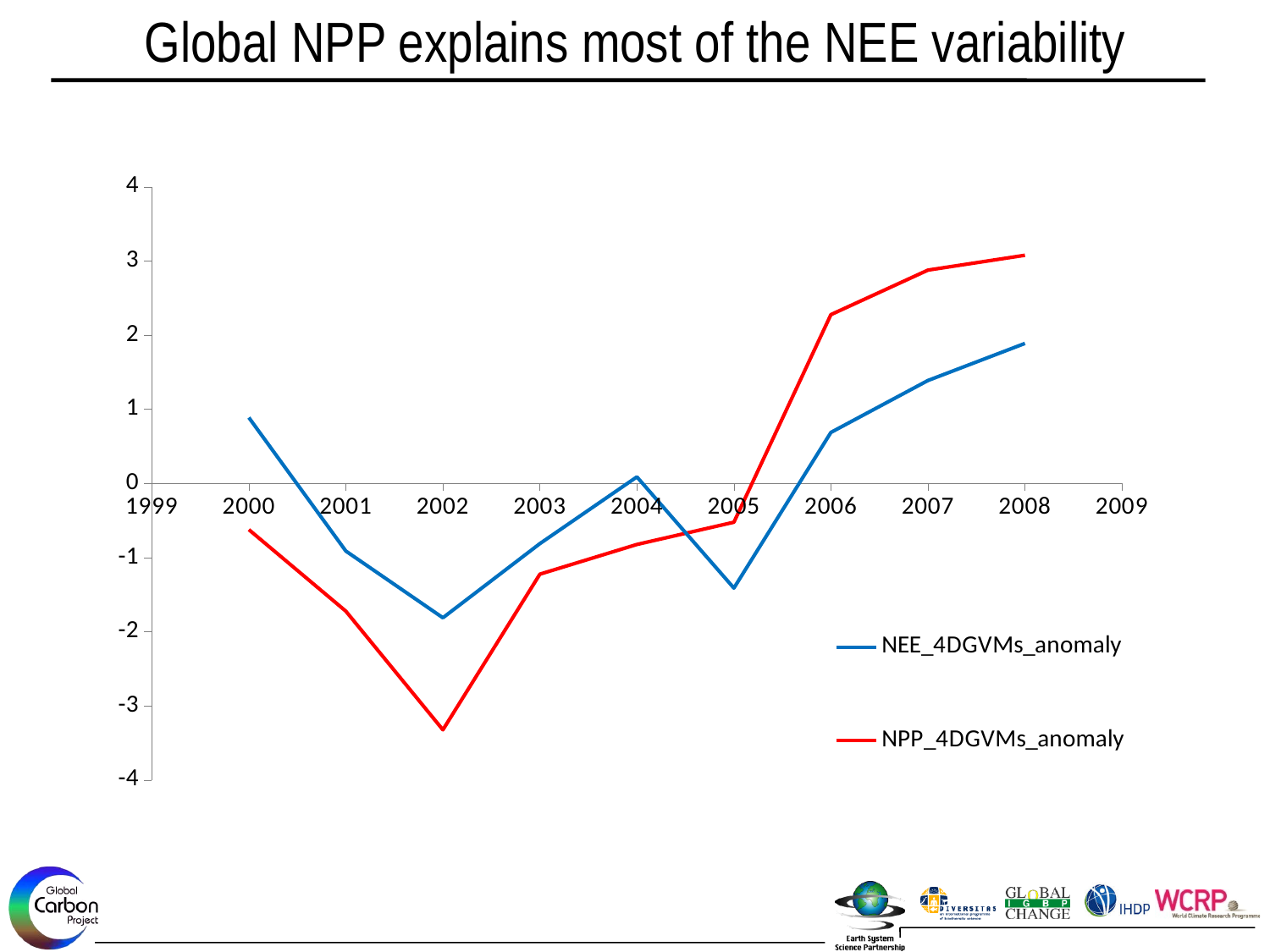
How many yearly data points does the NPP_4DGVMs_anomaly line have? 9 Is the NPP_4DGVMs_anomaly value for 2002 greater or less than -3? less In which year does the NEE_4DGVMs_anomaly line reach its lowest value? 2002 Is the NEE_4DGVMs_anomaly value for 2002 greater or less than -1? less What kind of chart is shown on the slide? line chart In which year does the NPP_4DGVMs_anomaly line reach its lowest value? 2002 In 2006, which series has the larger value, NEE_4DGVMs_anomaly or NPP_4DGVMs_anomaly? NPP_4DGVMs_anomaly Do both lines rise or fall from 2005 to 2008? rise Which colour is used for the NPP_4DGVMs_anomaly line? red How many series does the legend list? 2 In which year does the NPP_4DGVMs_anomaly line reach its highest value? 2008